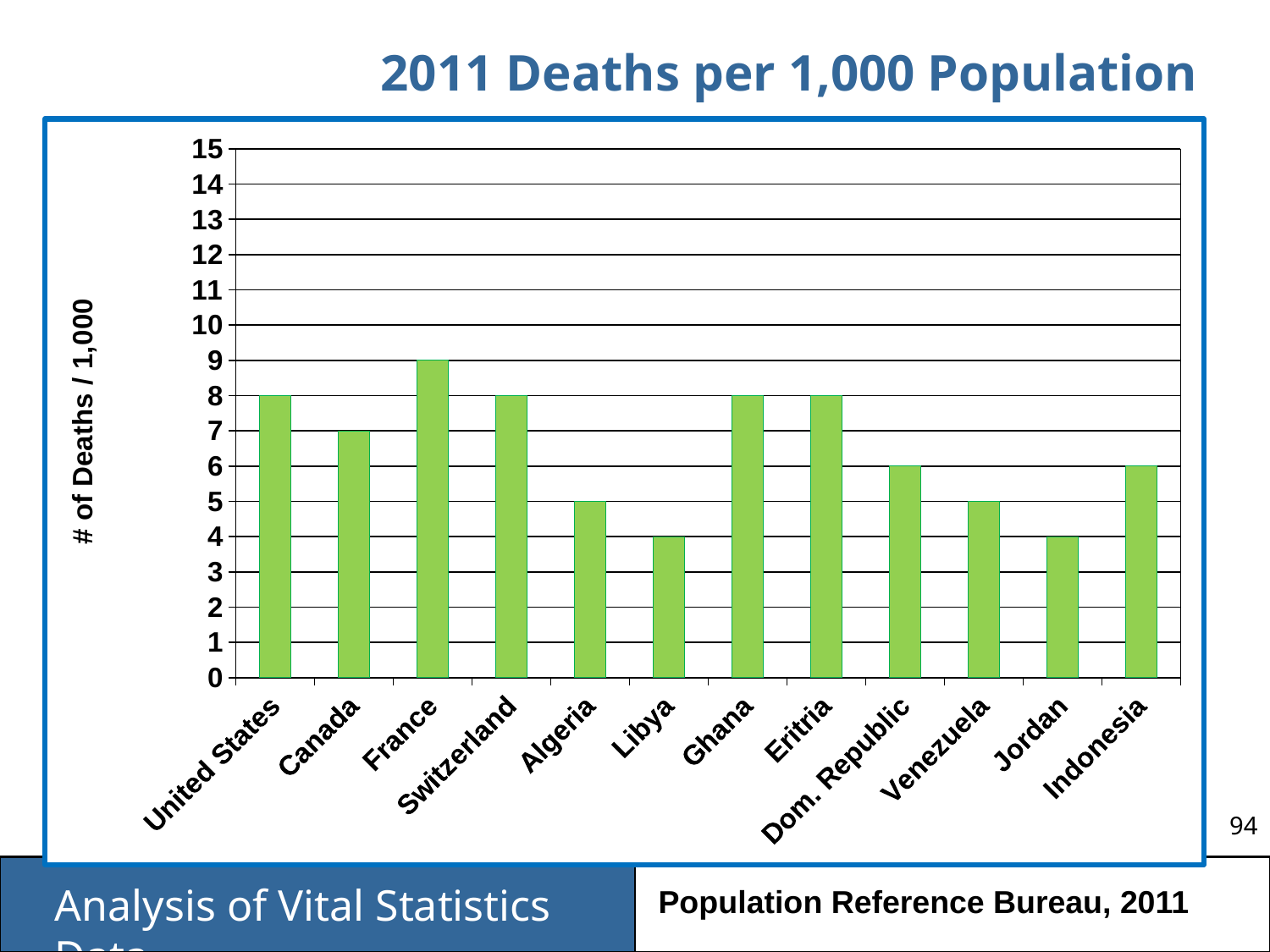
How many countries are shown on the chart? 12 What is the value for Algeria? 5 What is the value for Dom. Republic? 6 Which is larger, the value for Ghana or the value for Venezuela? Ghana What kind of chart is shown on the slide? bar chart What is the value for France? 9 What is the value for Canada? 7 What is the difference between the values for France and Canada? 2 What is the title of the chart? 2011 Deaths per 1,000 Population Which country has the highest number of deaths per 1,000? France What is the label on the vertical axis? # of Deaths / 1,000 Is the value for Libya greater or less than 5? less